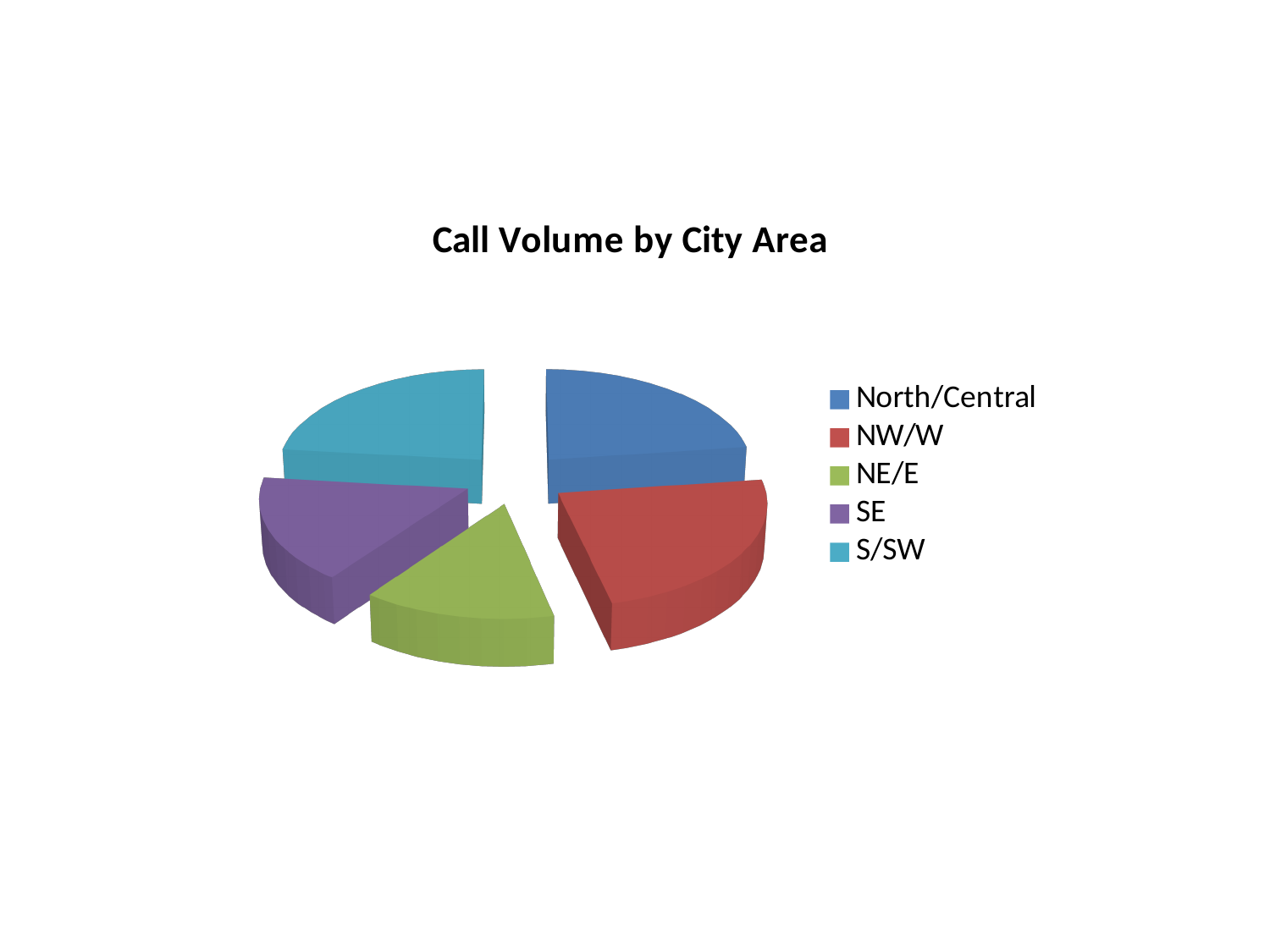
What kind of chart is shown on the slide? pie chart Which slice is larger, NW/W or NE/E? NW/W How many city areas (slices) does the pie chart show? 5 Which slice is larger, S/SW or NE/E? S/SW How many entries does the legend list? 5 Which city area is shown in blue in the pie chart? North/Central Which city area has the smallest slice of the pie? NE/E What is the title of the chart? Call Volume by City Area